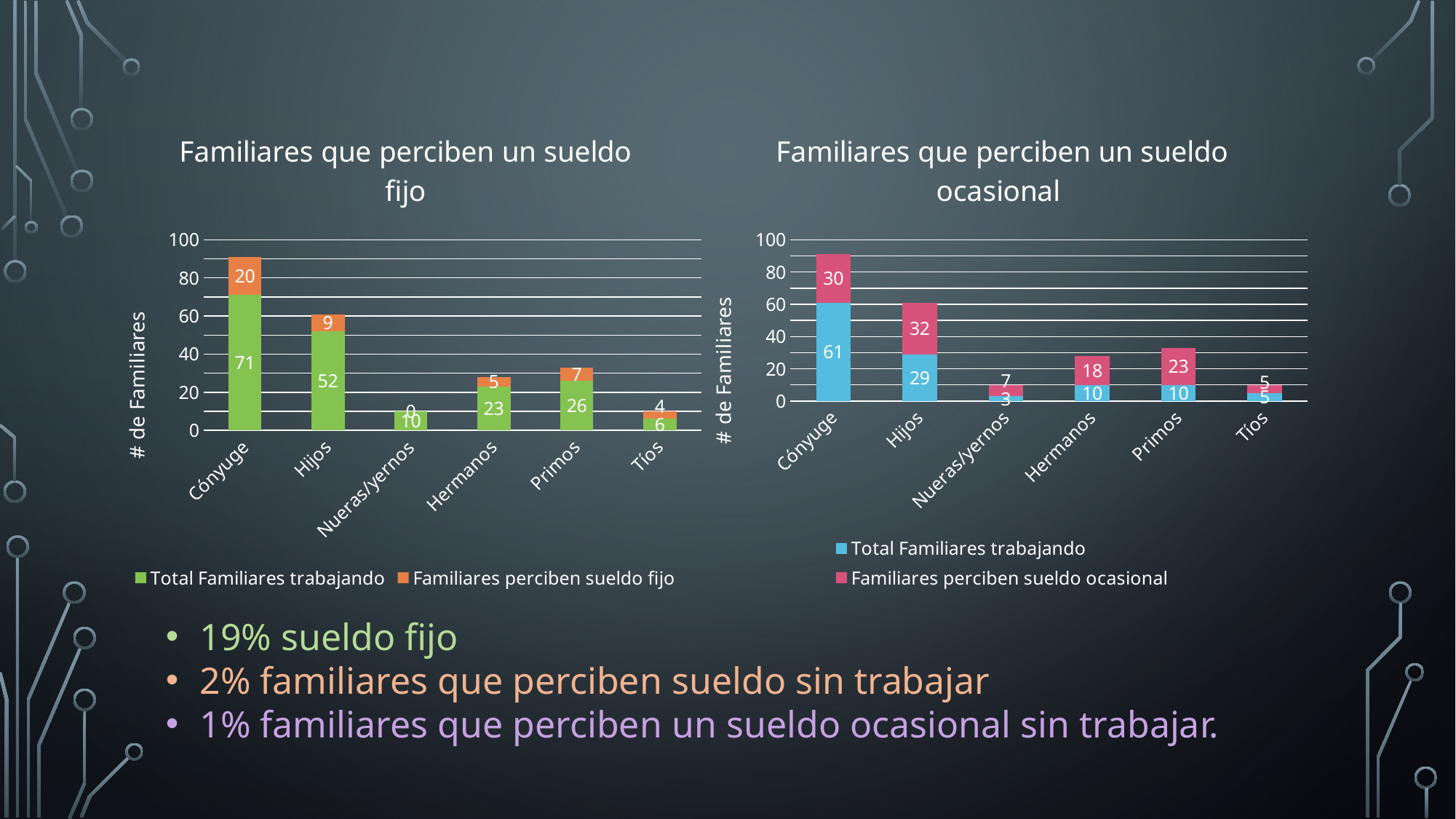
How many categories are shown on the x axis of the chart titled "Familiares que perciben un sueldo fijo"? 6 In the chart titled "Familiares que perciben un sueldo ocasional", what is the value of "Familiares perciben sueldo ocasional" for Primos? 23 In the chart titled "Familiares que perciben un sueldo fijo", what is the value of "Familiares perciben sueldo fijo" for Hijos? 9 What kind of chart is the chart titled "Familiares que perciben un sueldo ocasional"? Stacked bar chart In the chart titled "Familiares que perciben un sueldo ocasional", what is the total of the stacked bar for Hijos? 61 In the chart titled "Familiares que perciben un sueldo fijo", what is the value of "Total Familiares trabajando" for Cónyuge? 71 In the chart titled "Familiares que perciben un sueldo fijo", which category has the highest value for "Total Familiares trabajando"? Cónyuge In the chart titled "Familiares que perciben un sueldo fijo", what is the difference between the "Total Familiares trabajando" values for Cónyuge and Hijos? 19 In the chart titled "Familiares que perciben un sueldo ocasional", which category has the lowest value for "Total Familiares trabajando"? Nueras/yernos In the chart titled "Familiares que perciben un sueldo fijo", what is the total of the stacked bar for Cónyuge? 91 In the chart titled "Familiares que perciben un sueldo ocasional", what is the value of "Total Familiares trabajando" for Hijos? 29 In the chart titled "Familiares que perciben un sueldo ocasional", which is larger for Hermanos: "Total Familiares trabajando" or "Familiares perciben sueldo ocasional"? Familiares perciben sueldo ocasional